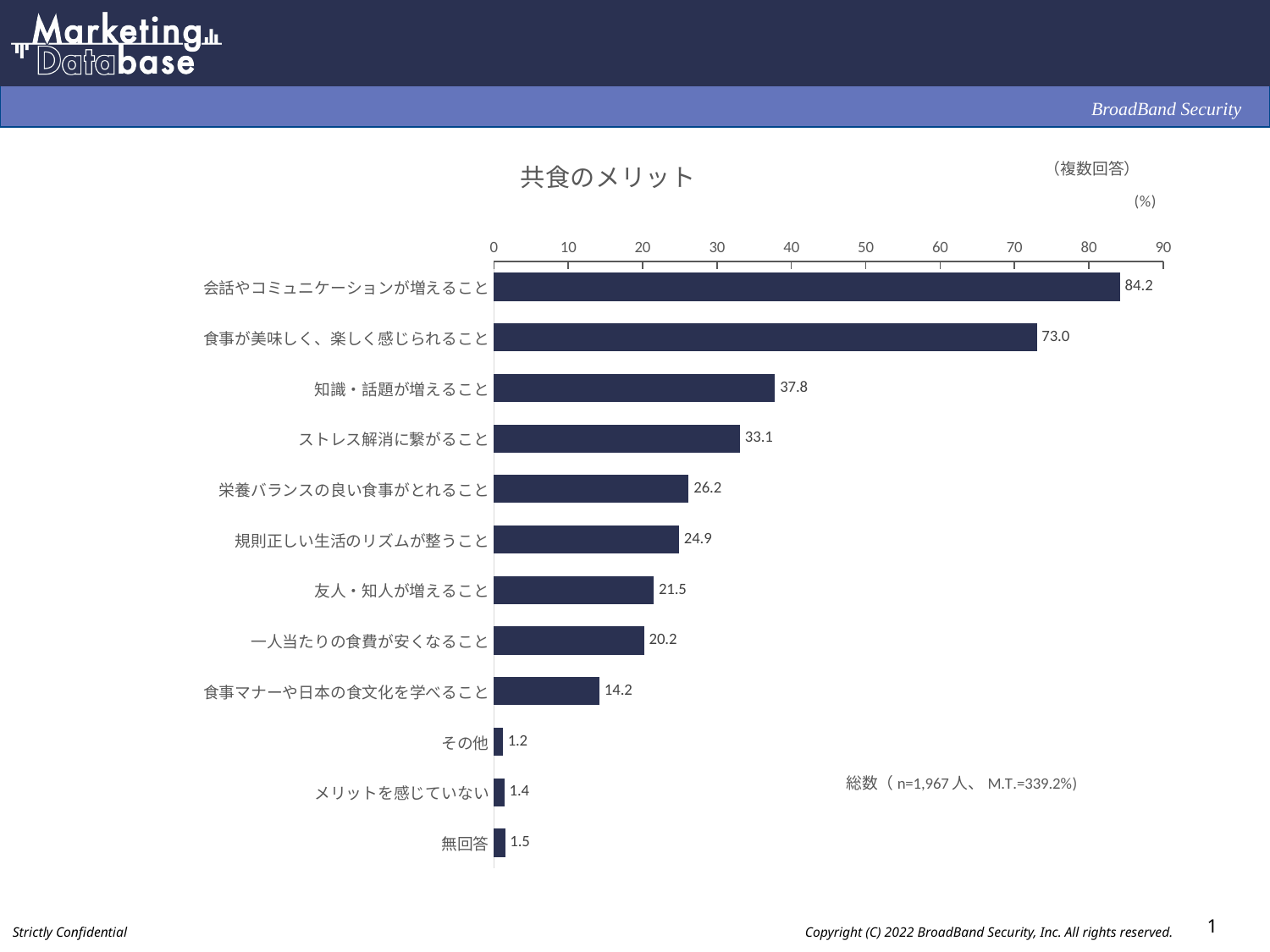
Is the value for 食事が美味しく、楽しく感じられること greater or less than 70? greater What type of chart is shown on the slide? bar chart What is the title of the chart? 共食のメリット Which category has the lowest value? その他 Which is larger, the value for ストレス解消に繋がること or the value for 栄養バランスの良い食事がとれること? ストレス解消に繋がること What is the difference between the values for 会話やコミュニケーションが増えること and 食事が美味しく、楽しく感じられること? 11.2 How many categories are plotted in the chart? 12 What is the value for 知識・話題が増えること? 37.8 What is the value for 会話やコミュニケーションが増えること? 84.2 What is the value for 食事マナーや日本の食文化を学べること? 14.2 What is the difference between the values for 友人・知人が増えること and 一人当たりの食費が安くなること? 1.3 Which category has the highest value? 会話やコミュニケーションが増えること